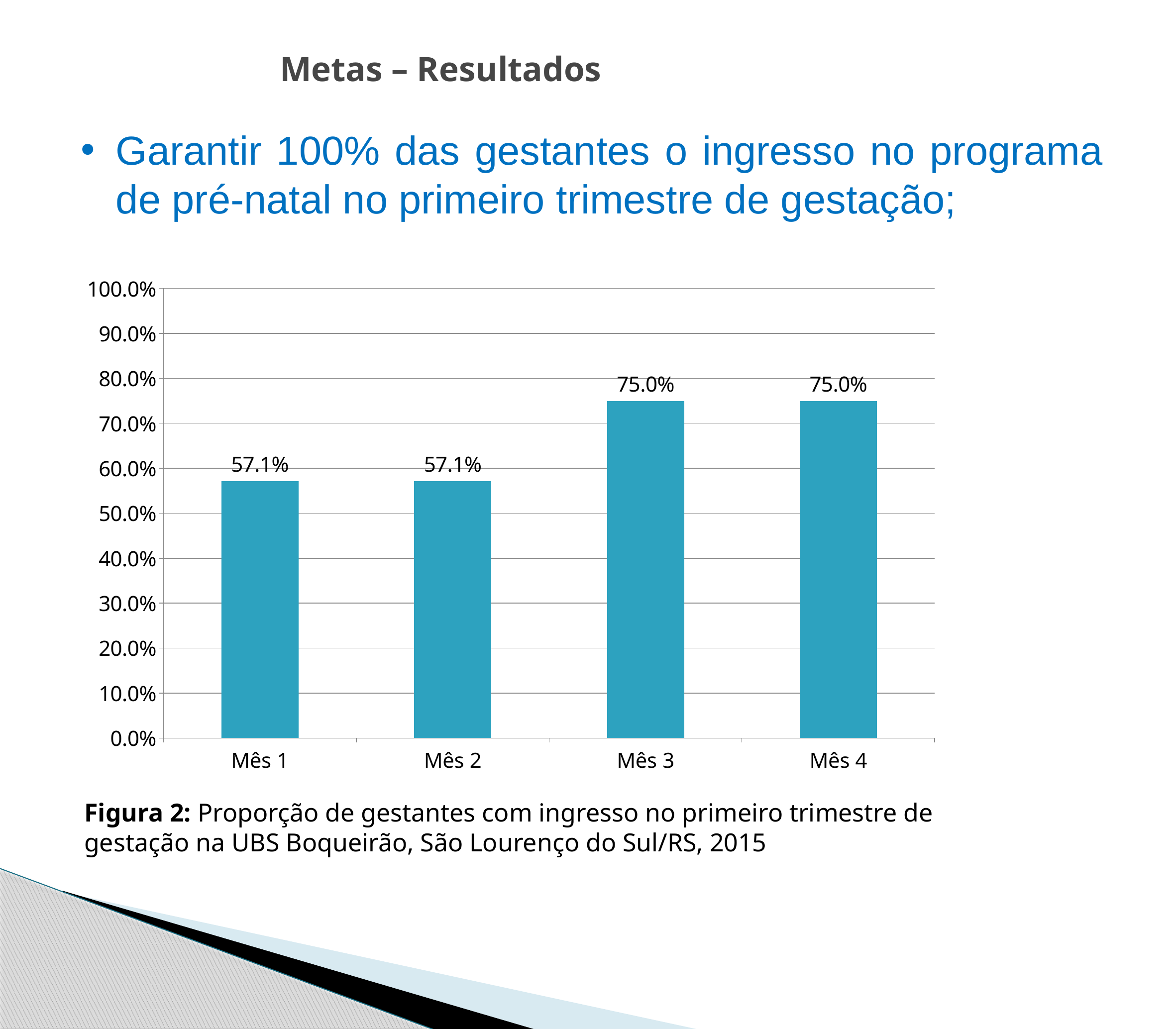
What kind of chart is shown on the slide? bar chart Is the value for Mês 3 greater or less than 80.0%? less What is the difference between the values for Mês 3 and Mês 1? 17.9% How many categories are shown on the x axis? 4 What is the value for Mês 1? 57.1% What is the value for Mês 2? 57.1% Is the value for Mês 1 greater or less than 50.0%? greater What is the highest value shown on the y axis? 100.0% What is the value for Mês 4? 75.0% What is the value for Mês 3? 75.0% Do the values rise or fall from Mês 1 to Mês 4? rise Which is larger, the value for Mês 2 or the value for Mês 4? Mês 4